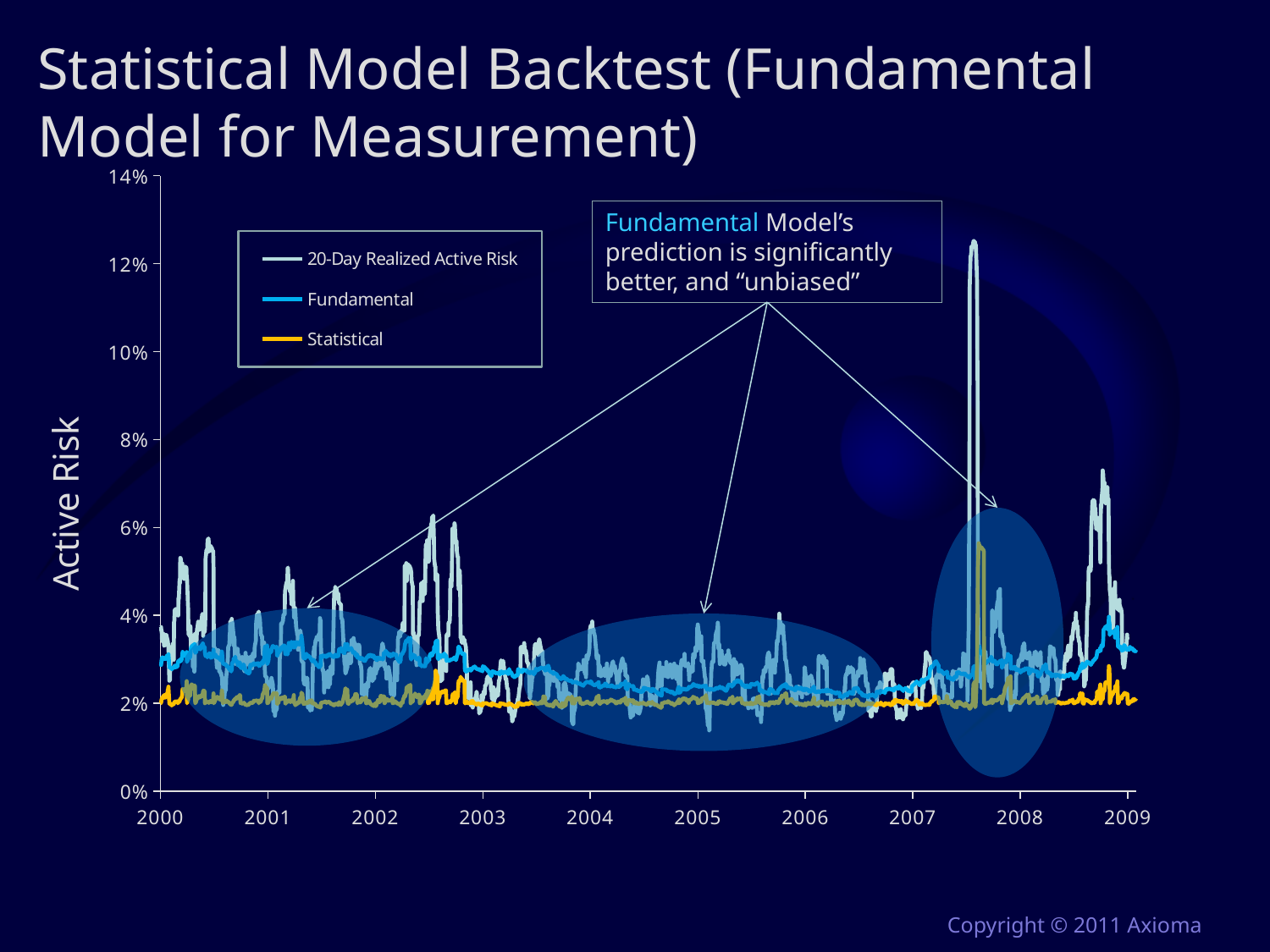
Which series is drawn in yellow/orange according to the legend? Statistical Is the Statistical series value at the start of 2004 greater or less than 4%? less Is the highest peak of the 20-Day Realized Active Risk series greater or less than 10%? greater How many series does the legend list? 3 What is the label on the vertical axis? Active Risk How many year labels are shown on the horizontal axis? 10 Which series reaches the highest peak on the chart? 20-Day Realized Active Risk What is the last year labelled on the horizontal axis? 2009 What is the highest value shown on the vertical axis? 14% What is the first year labelled on the horizontal axis? 2000 Is the Fundamental series value at the start of 2000 greater or less than 4%? less What kind of chart is shown on the slide? line chart